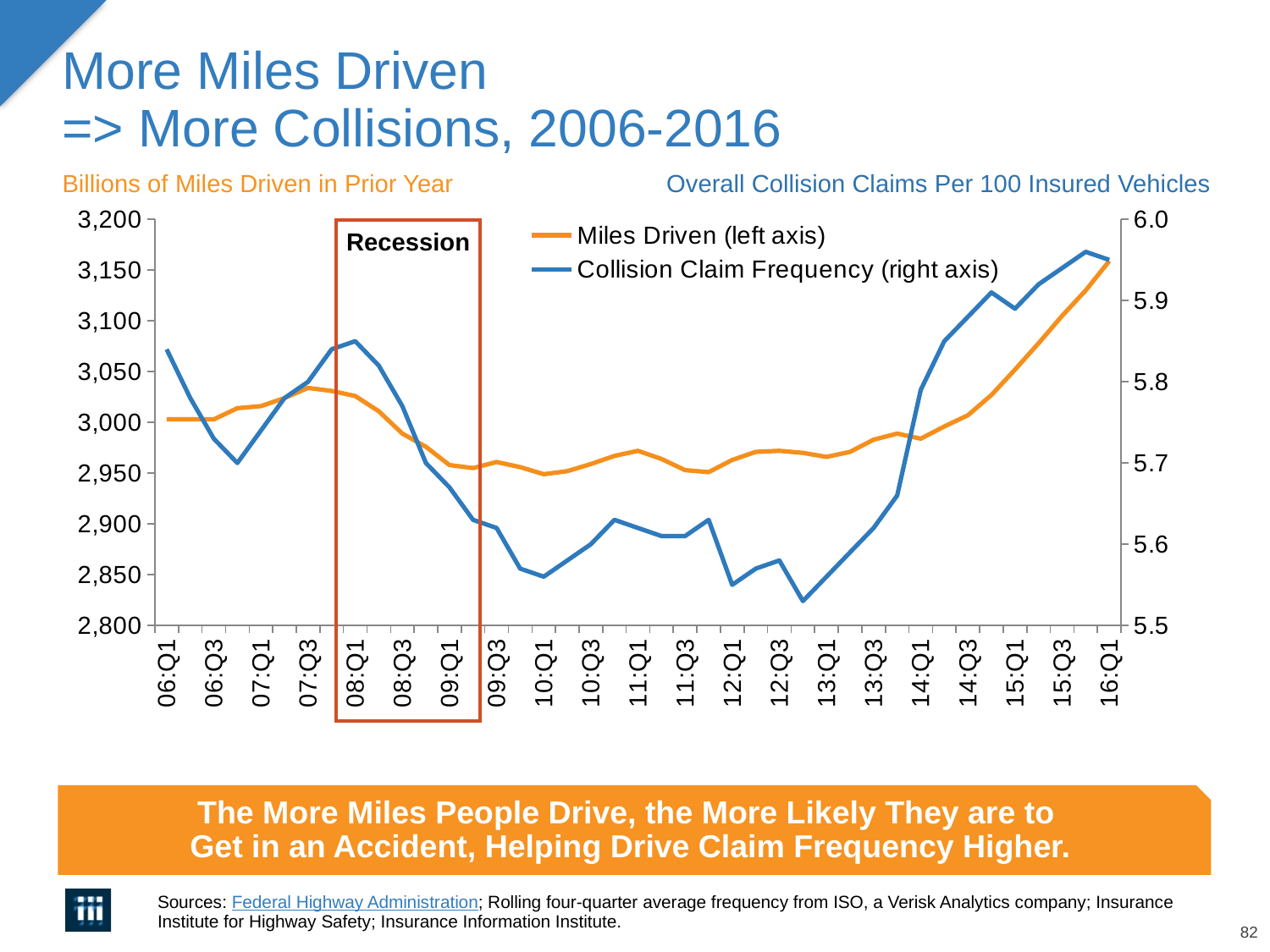
How many series does the legend list? 2 How many labels are shown on the x axis? 21 Is Miles Driven larger at 16:Q1 or at 06:Q1? 16:Q1 Is the value for Miles Driven at 10:Q1 greater or less than 3,000? less What kind of chart is shown on the slide? line chart What label is shown inside the red box on the chart? Recession Is the value for Collision Claim Frequency at 13:Q1 greater or less than 5.6? less Does Collision Claim Frequency rise or fall between 08:Q1 and 10:Q1? fall Which series is plotted against the right axis? Collision Claim Frequency Is the value for Collision Claim Frequency at 16:Q1 greater or less than 5.9? greater At which x-axis label does Miles Driven reach its highest value? 16:Q1